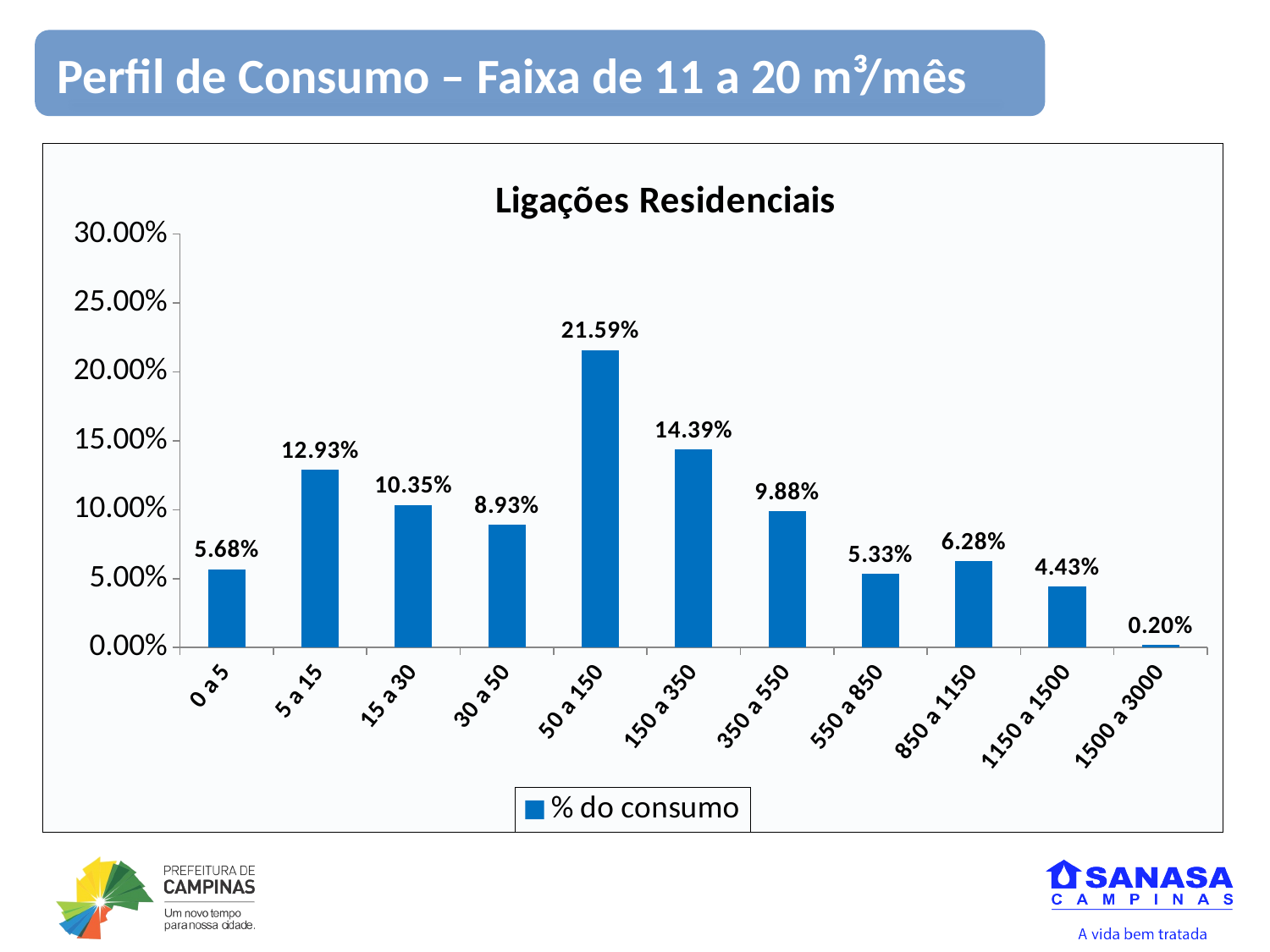
What kind of chart is shown? bar chart How many categories are shown on the x axis? 11 What is the difference between the values for "50 a 150" and "150 a 350"? 7.20% What is the value for the category "1500 a 3000"? 0.20% Which is larger, the value for "5 a 15" or the value for "15 a 30"? 5 a 15 What is the title of the chart? Ligações Residenciais How many series does the legend list? 1 Which category has the highest value? 50 a 150 Is the value for "350 a 550" greater or less than 10.00%? less What is the value for the category "0 a 5"? 5.68% Which category has the lowest value? 1500 a 3000 What is the value for the category "50 a 150"? 21.59%